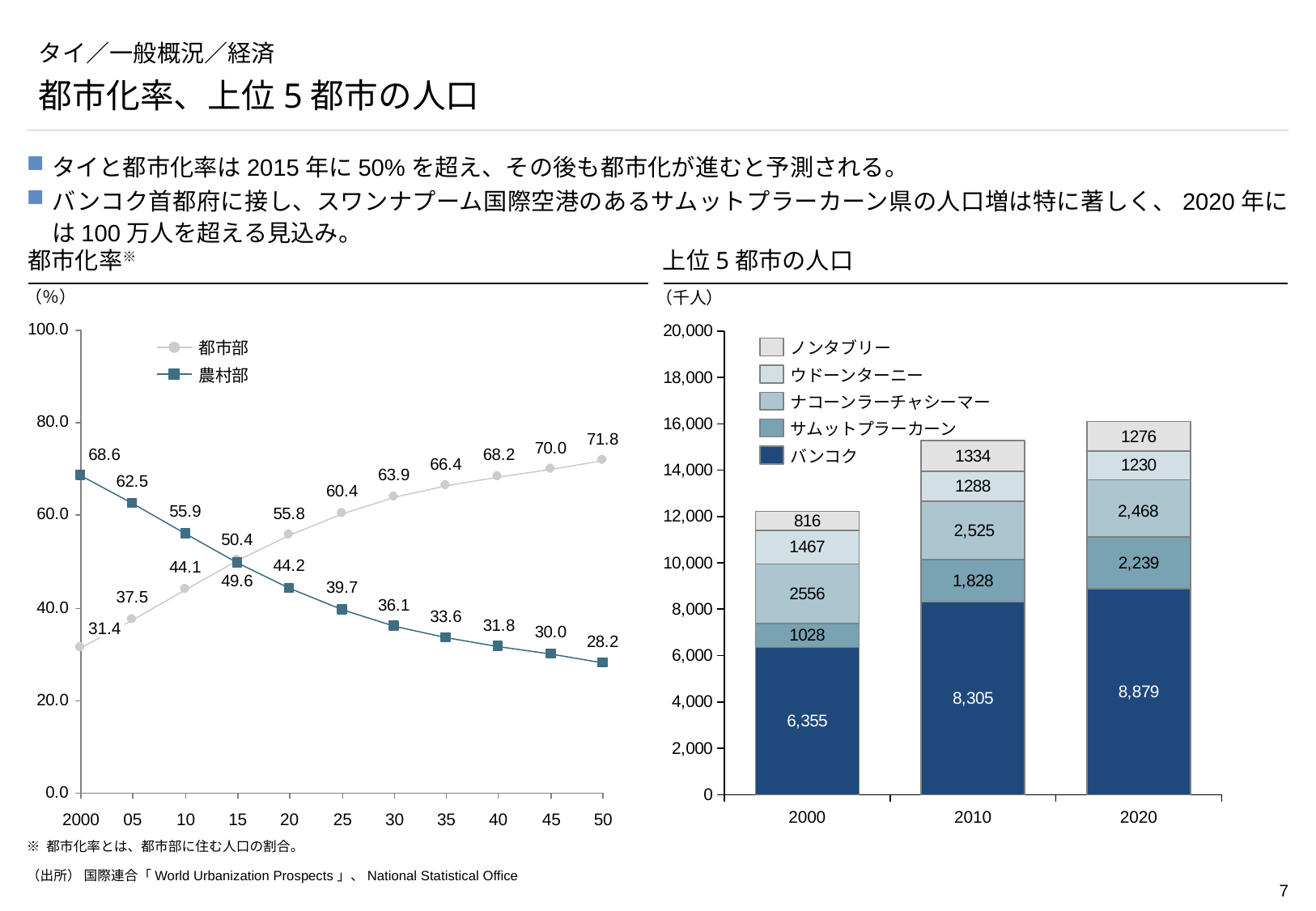
In the 上位5都市の人口 chart on the right, what is the total of the stacked bar for 2010? 15,280 In the 上位5都市の人口 chart on the right, how many series does the legend list? 5 In the 上位5都市の人口 chart on the right, what is the value for バンコク in 2020? 8,879 In the 都市化率 chart on the left, what is the difference between 都市部 and 農村部 in 2015? 0.8 In the 都市化率 chart on the left, does the 農村部 series rise or fall along the x axis? fall In the 都市化率 chart on the left, which series is higher in 2010, 都市部 or 農村部? 農村部 In the 都市化率 chart on the left, what is the value for 都市部 in 2000? 31.4 In the 都市化率 chart on the left, how many series does the legend list? 2 In the 都市化率 chart on the left, what is the value for 農村部 in 2050? 28.2 In the 上位5都市の人口 chart on the right, what kind of chart is it? stacked bar chart In the 上位5都市の人口 chart on the right, what is the value for サムットプラーカーン in 2000? 1028 In the 上位5都市の人口 chart on the right, which year has the highest バンコク value? 2020